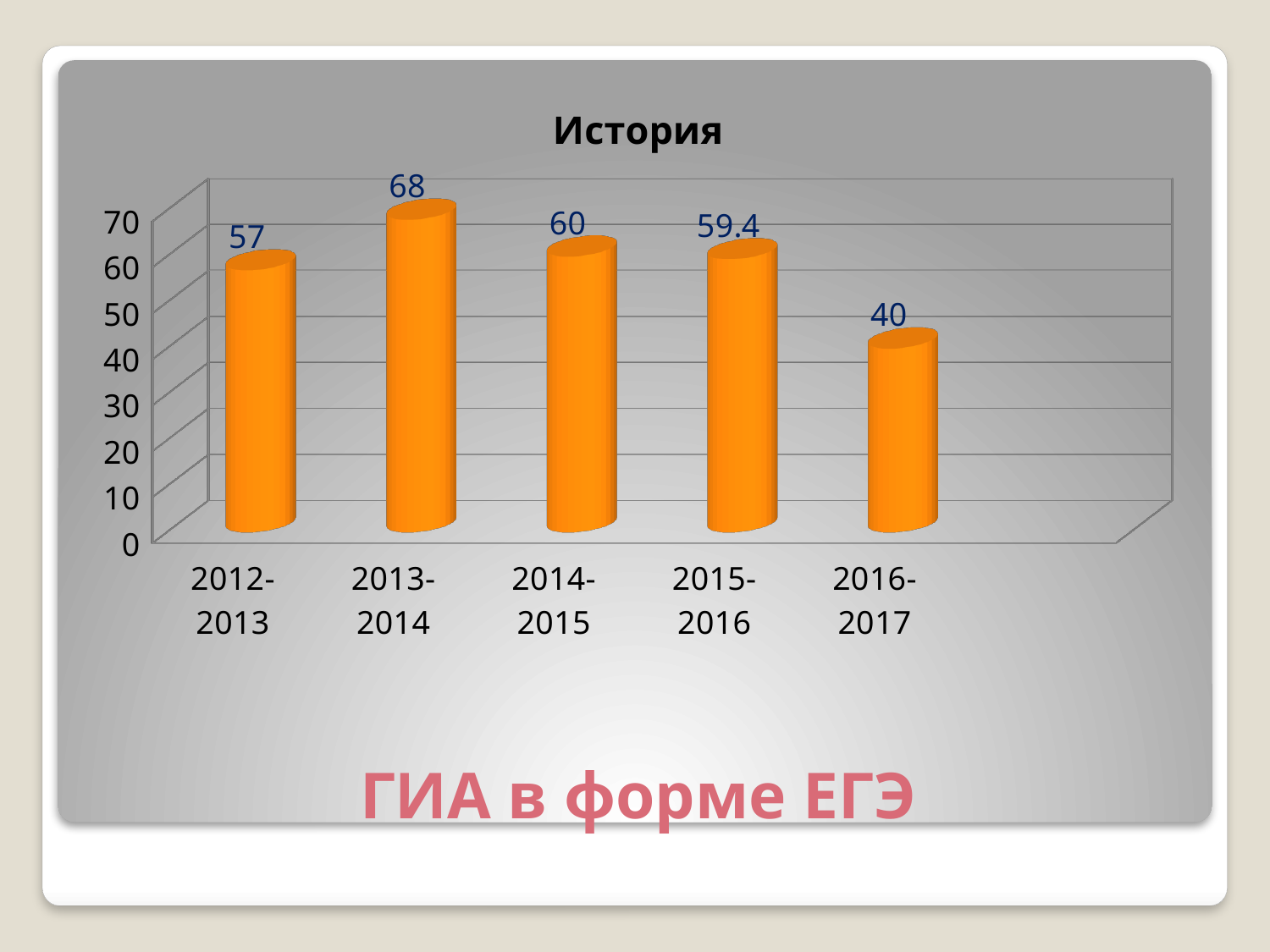
What is the title of the chart? История What is the difference between the values for 2013-2014 and 2016-2017? 28 What is the value for 2013-2014? 68 How many years are shown on the x axis? 5 What is the value for 2012-2013? 57 Which year has the lowest value? 2016-2017 Is the value for 2016-2017 greater or less than 50? less Which is larger, the value for 2012-2013 or the value for 2014-2015? 2014-2015 What is the value for 2016-2017? 40 Which year has the highest value? 2013-2014 What is the value for 2015-2016? 59.4 What kind of chart is shown? bar chart